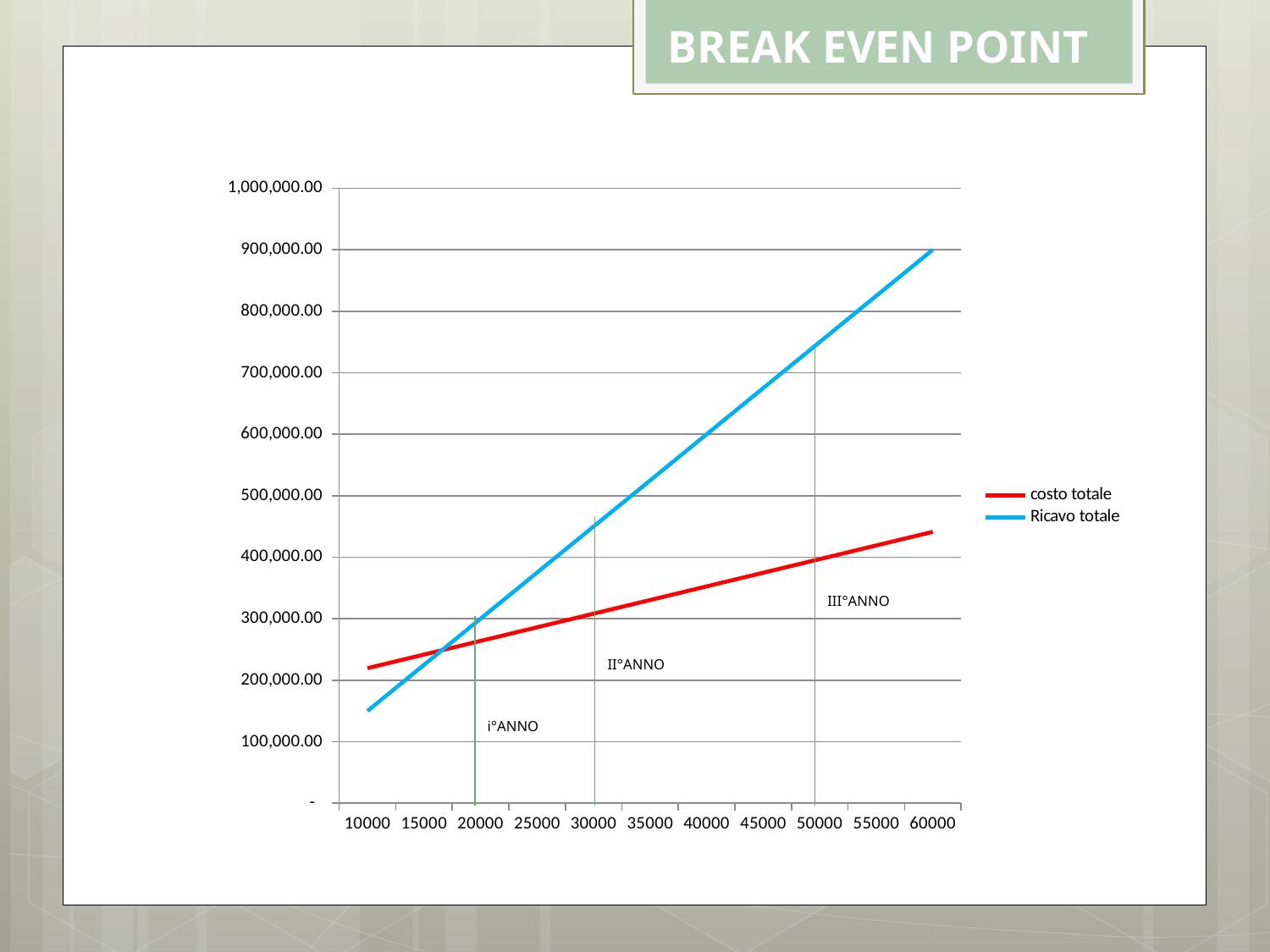
What is the value of Ricavo totale at 60000? 900,000.00 Is the value of costo totale at 10000 greater or less than 200,000.00? greater What kind of chart is shown on the slide? line chart Is the value of costo totale at 60000 greater or less than 400,000.00? greater Is the value of Ricavo totale at 10000 greater or less than 200,000.00? less At 10000, which series has the larger value, costo totale or Ricavo totale? costo totale At 60000, which series has the larger value, costo totale or Ricavo totale? Ricavo totale Does the Ricavo totale line rise or fall as the x-axis values increase? rise How many series does the legend list? 2 What is the title of the slide containing the chart? BREAK EVEN POINT Which colour is used for the Ricavo totale line? blue